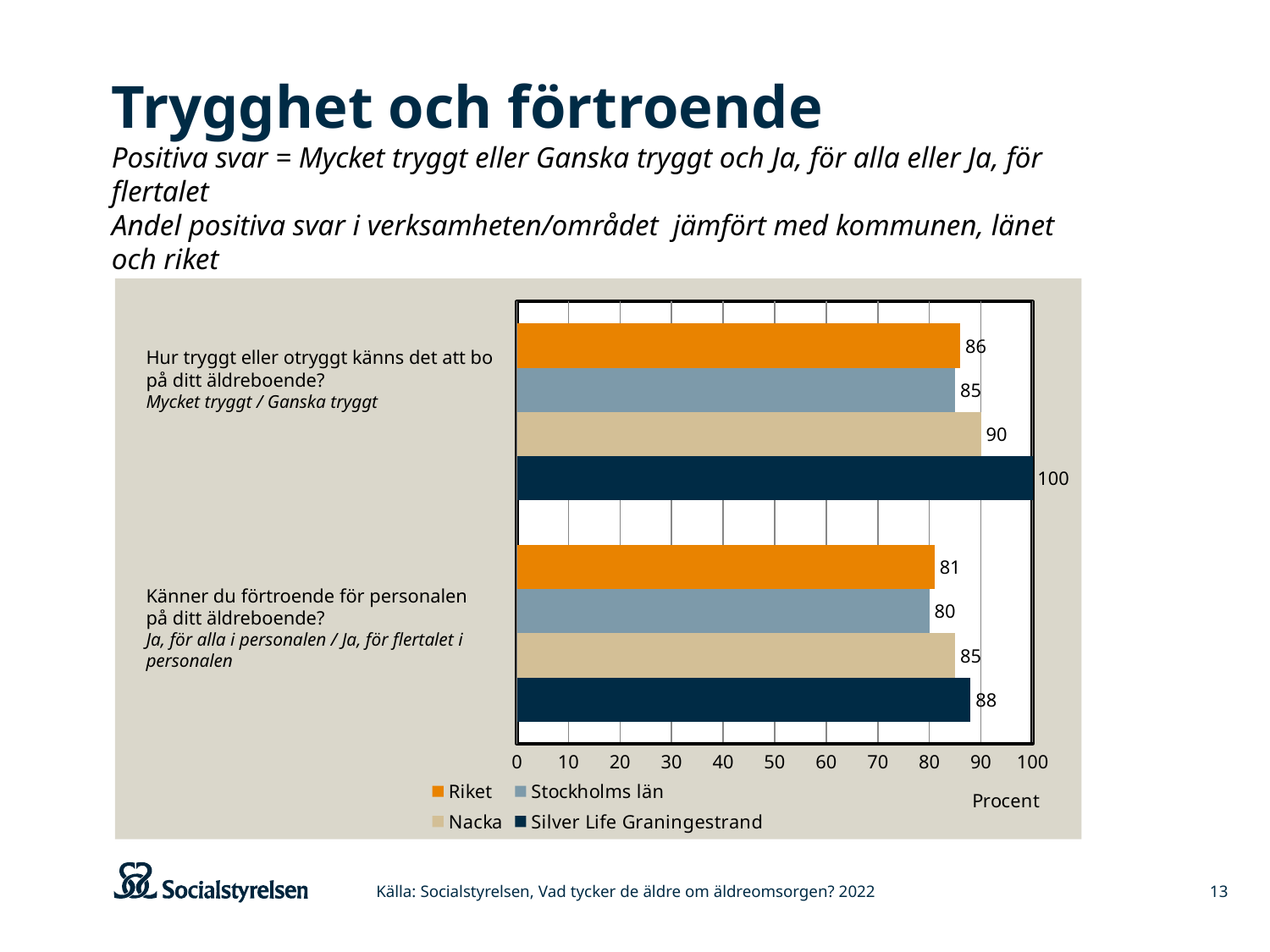
What is the value for Stockholms län on the question "Känner du förtroende för personalen på ditt äldreboende?"? 80 What is the value for Nacka on the question "Hur tryggt eller otryggt känns det att bo på ditt äldreboende?"? 90 Which is larger on the question "Känner du förtroende för personalen på ditt äldreboende?": Nacka or Riket? Nacka Which series has the highest value on the question "Känner du förtroende för personalen på ditt äldreboende?"? Silver Life Graningestrand What type of chart is shown on the slide? bar chart What is the value for Riket on the question "Känner du förtroende för personalen på ditt äldreboende?"? 81 What is the value for Silver Life Graningestrand on the question "Hur tryggt eller otryggt känns det att bo på ditt äldreboende?"? 100 What unit is shown on the x axis of the chart? Procent Which series has the lowest value on the question "Hur tryggt eller otryggt känns det att bo på ditt äldreboende?"? Stockholms län What is the difference between Silver Life Graningestrand and Riket on the question "Hur tryggt eller otryggt känns det att bo på ditt äldreboende?"? 14 How many questions (categories) are shown on the chart? 2 How many series does the legend list? 4